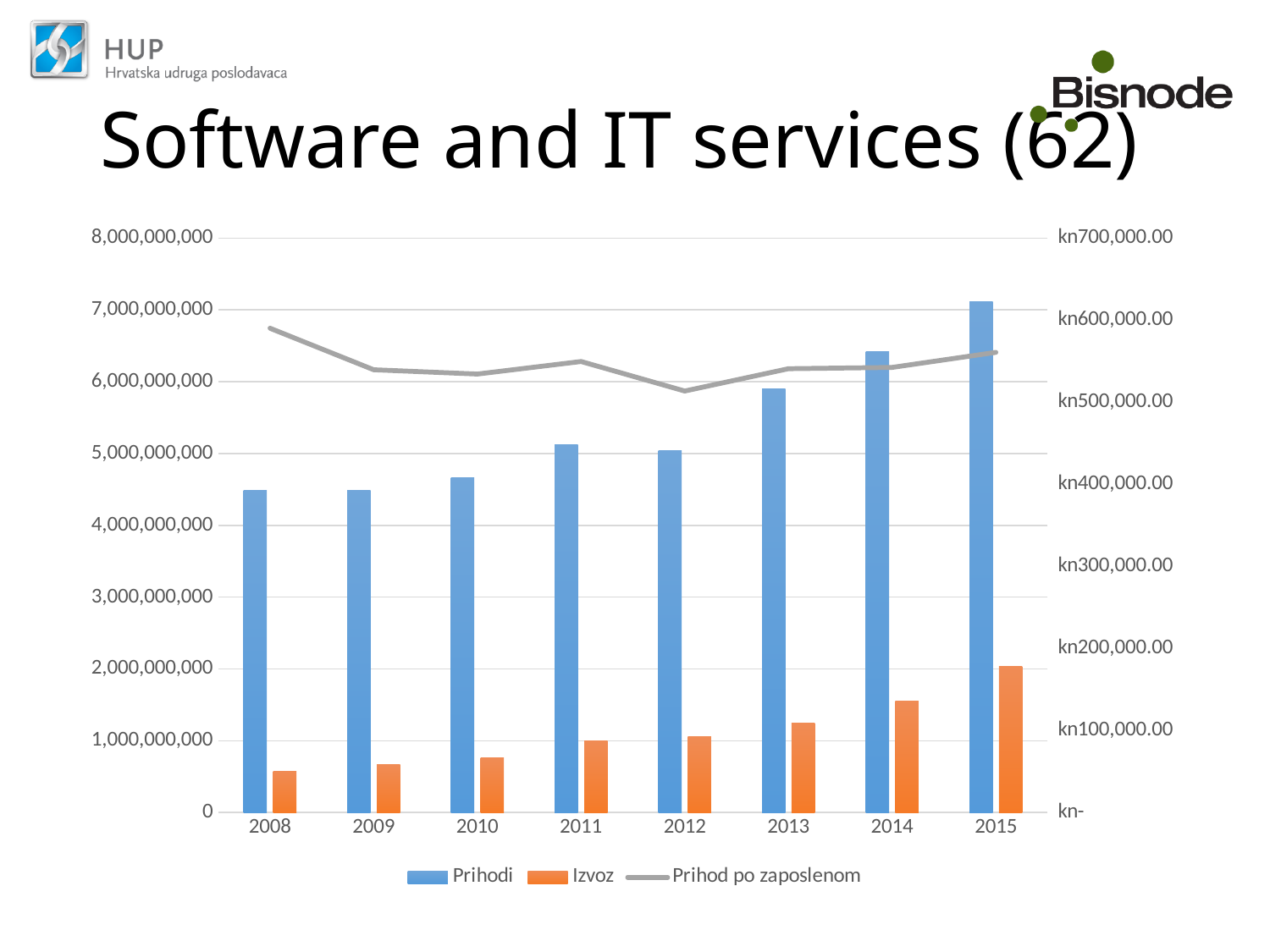
Which is larger, the Prihodi value for 2013 or for 2014? 2014 In which year is the Prihodi bar the highest? 2015 In which year is the Prihod po zaposlenom line at its lowest point? 2012 In which year is the Prihod po zaposlenom line at its highest point? 2008 How many years are shown on the x axis of the chart? 8 Is the Prihodi value for 2015 greater or less than 7,000,000,000? greater What kind of chart is shown on the slide? Bar chart with a line In which year is the Izvoz bar the lowest? 2008 How many series does the chart legend list? 3 Do the Izvoz values generally rise or fall from 2008 to 2015? rise Is the Izvoz value for 2008 greater or less than 1,000,000,000? less Is the Izvoz value for 2014 greater or less than 1,000,000,000? greater